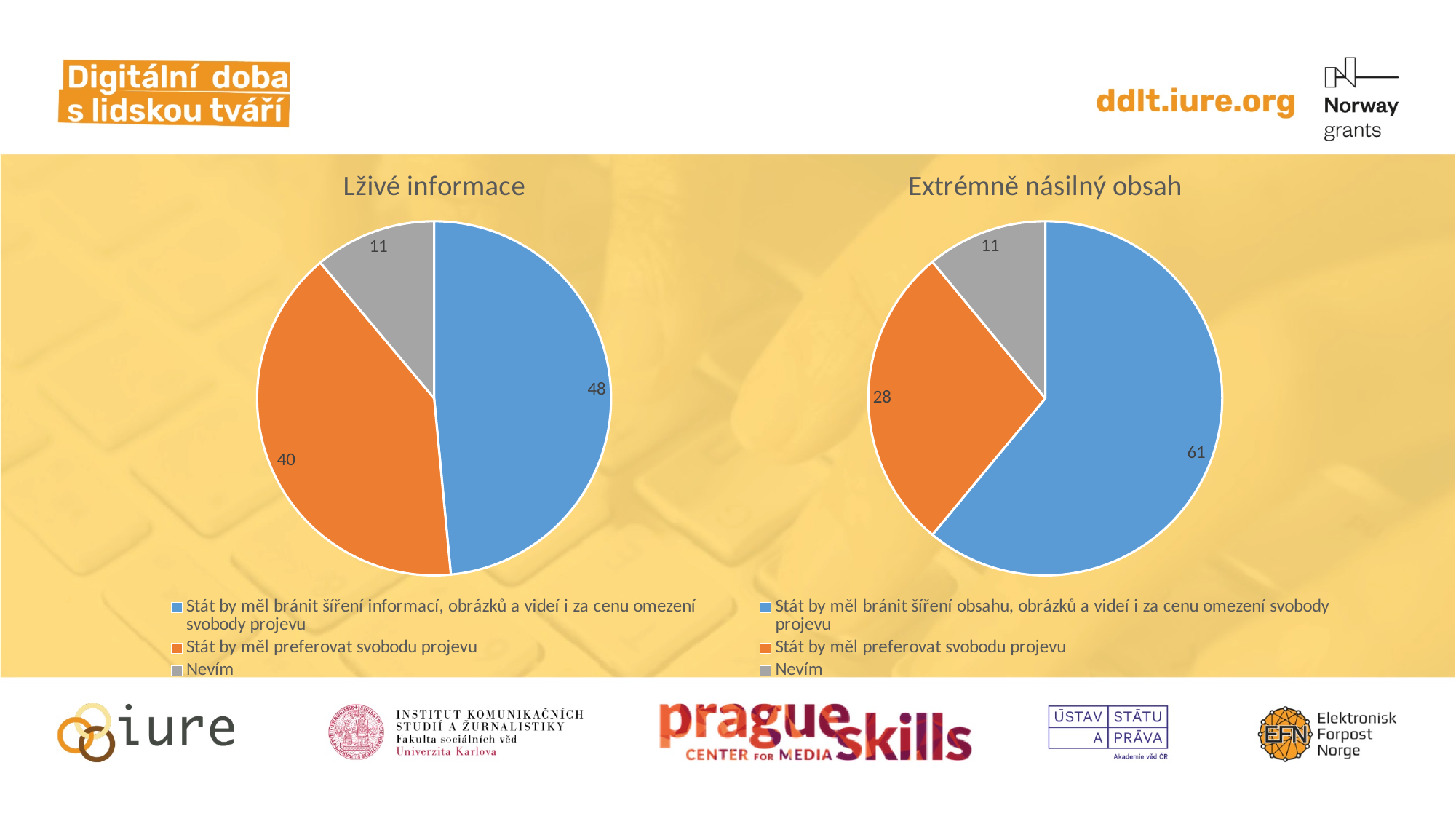
In the 'Extrémně násilný obsah' chart, which category has the smallest slice? Nevím Which chart has the larger value for 'Stát by měl preferovat svobodu projevu', 'Lživé informace' or 'Extrémně násilný obsah'? Lživé informace What type of chart is used for 'Lživé informace'? Pie chart How many slices does the 'Extrémně násilný obsah' chart have? 3 In the 'Extrémně násilný obsah' chart, what is the difference between the value for 'Stát by měl bránit šíření obsahu, obrázků a videí i za cenu omezení svobody projevu' and the value for 'Stát by měl preferovat svobodu projevu'? 33 In the 'Extrémně násilný obsah' chart, what value is shown for 'Stát by měl bránit šíření obsahu, obrázků a videí i za cenu omezení svobody projevu'? 61 In the 'Lživé informace' chart, what value is shown for 'Stát by měl preferovat svobodu projevu'? 40 In the 'Lživé informace' chart, what value is shown for 'Nevím'? 11 In the 'Lživé informace' chart, what is the difference between the value for 'Stát by měl preferovat svobodu projevu' and the value for 'Nevím'? 29 In the 'Lživé informace' chart, what colour is the slice for 'Nevím'? Grey In the 'Lživé informace' chart, which category has the largest slice? Stát by měl bránit šíření informací, obrázků a videí i za cenu omezení svobody projevu What is the title of the chart on the right side of the slide? Extrémně násilný obsah